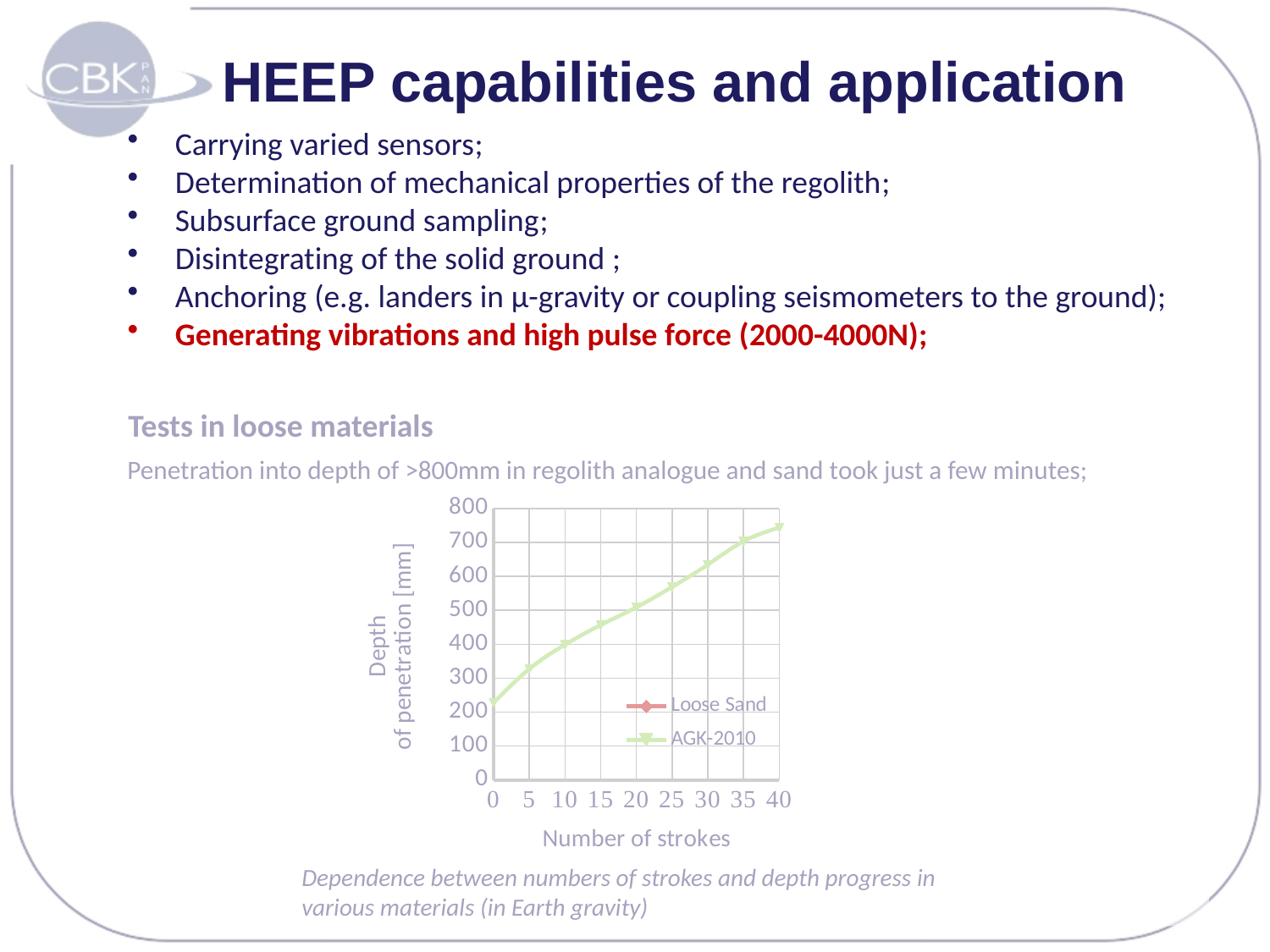
Is the depth of penetration for AGK-2010 at 0 strokes greater or less than 300? less Is the depth of penetration for AGK-2010 at 40 strokes greater or less than 700? greater Which number of strokes gives the greatest depth of penetration for AGK-2010? 40 Is the depth of penetration for AGK-2010 at 25 strokes greater or less than 500? greater Which number of strokes gives the smallest depth of penetration for AGK-2010? 0 Does the depth of penetration for AGK-2010 rise or fall as the number of strokes increases? rise What are the two series named in the chart legend? Loose Sand and AGK-2010 How many series does the chart legend list? 2 What kind of chart is shown on the slide? line chart What is the label of the x axis of the chart? Number of strokes